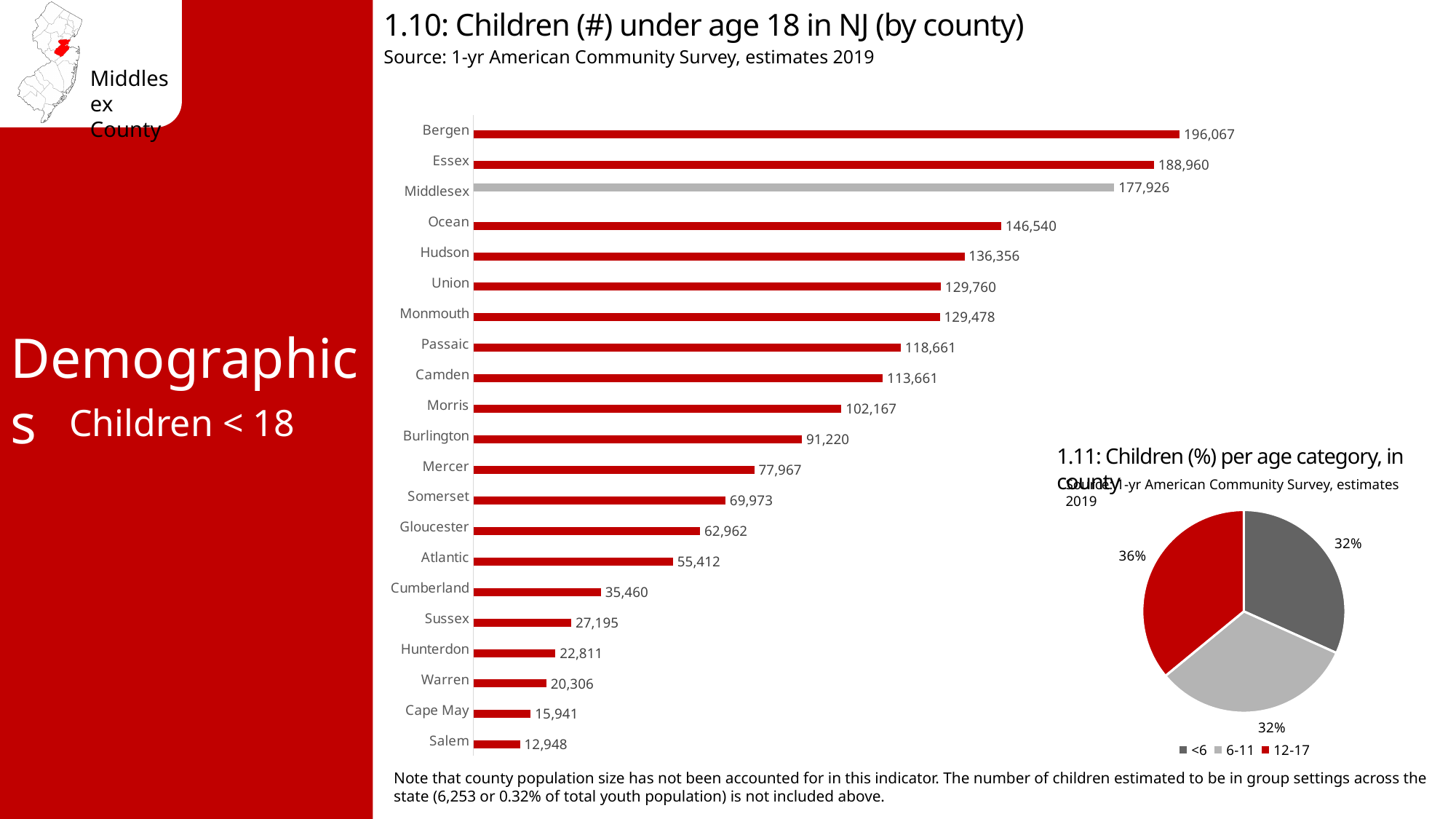
What type of chart is chart 1.10? Bar chart In chart 1.10, what is the difference between the number of children in Bergen and Essex counties? 7,107 How many age categories does the legend of chart 1.11 list? 3 In chart 1.11, which age category has the largest share? 12-17 In chart 1.10, which county has the lowest number of children under age 18? Salem In chart 1.10, which county's bar is shown in grey instead of red? Middlesex In chart 1.10, how many counties are shown? 21 In chart 1.11, what percentage of children are in the 12-17 age category? 36% In chart 1.10, which county has the highest number of children under age 18? Bergen In chart 1.10, which county has more children under 18, Passaic or Camden? Passaic In chart 1.10, how many children under age 18 are in Middlesex County? 177,926 In chart 1.10, how many children under age 18 are in Ocean County? 146,540